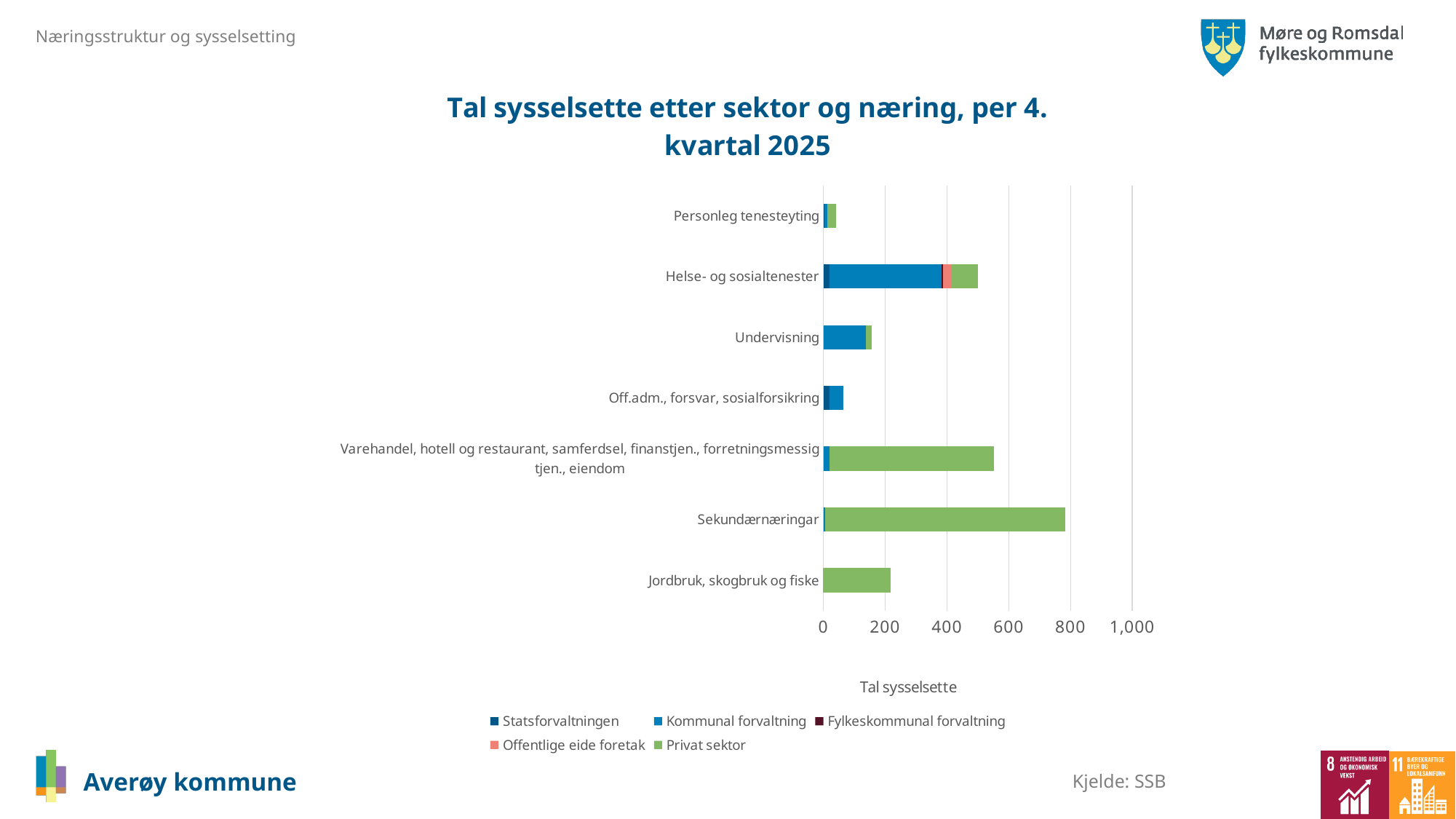
What is the label on the horizontal axis of the chart? Tal sysselsette Is the total value for Varehandel, hotell og restaurant, samferdsel, finanstjen., forretningsmessig tjen., eiendom greater or less than 400? greater How many series does the legend list? 5 What is the title of the chart? Tal sysselsette etter sektor og næring, per 4. kvartal 2025 Is the total value for Jordbruk, skogbruk og fiske greater or less than 400? less Is the total value for Undervisning greater or less than 200? less What kind of chart is shown on the slide? Bar chart Which category has the longest total bar? Sekundærnæringar Which category has the shortest total bar? Personleg tenesteyting Which has a larger total bar, Sekundærnæringar or Jordbruk, skogbruk og fiske? Sekundærnæringar How many categories (næringar) are plotted on the chart? 7